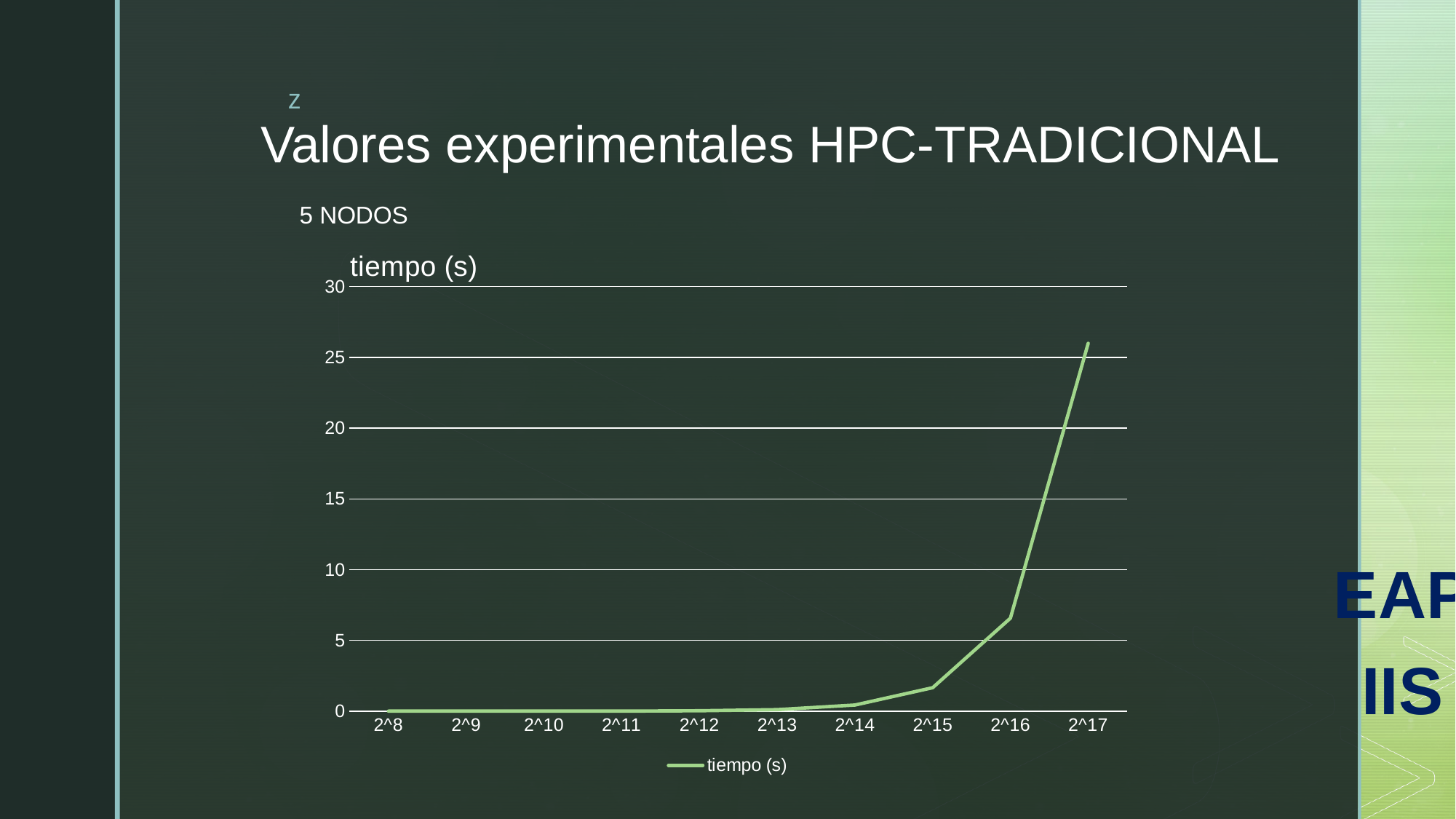
What is the title of the chart? tiempo (s) Is the value for 2^16 greater or less than 10? less How many points are plotted along the x axis of the chart? 10 What is the name of the series shown in the chart legend? tiempo (s) What kind of chart is shown on the slide? line chart Is the value for 2^17 greater or less than 30? less Which has a larger value, 2^16 or 2^17? 2^17 Is the value for 2^17 greater or less than 25? greater Which x-axis category has the highest value for tiempo (s)? 2^17 How many series does the chart legend list? 1 Do the values of tiempo (s) rise or fall as the x axis goes from 2^8 to 2^17? rise